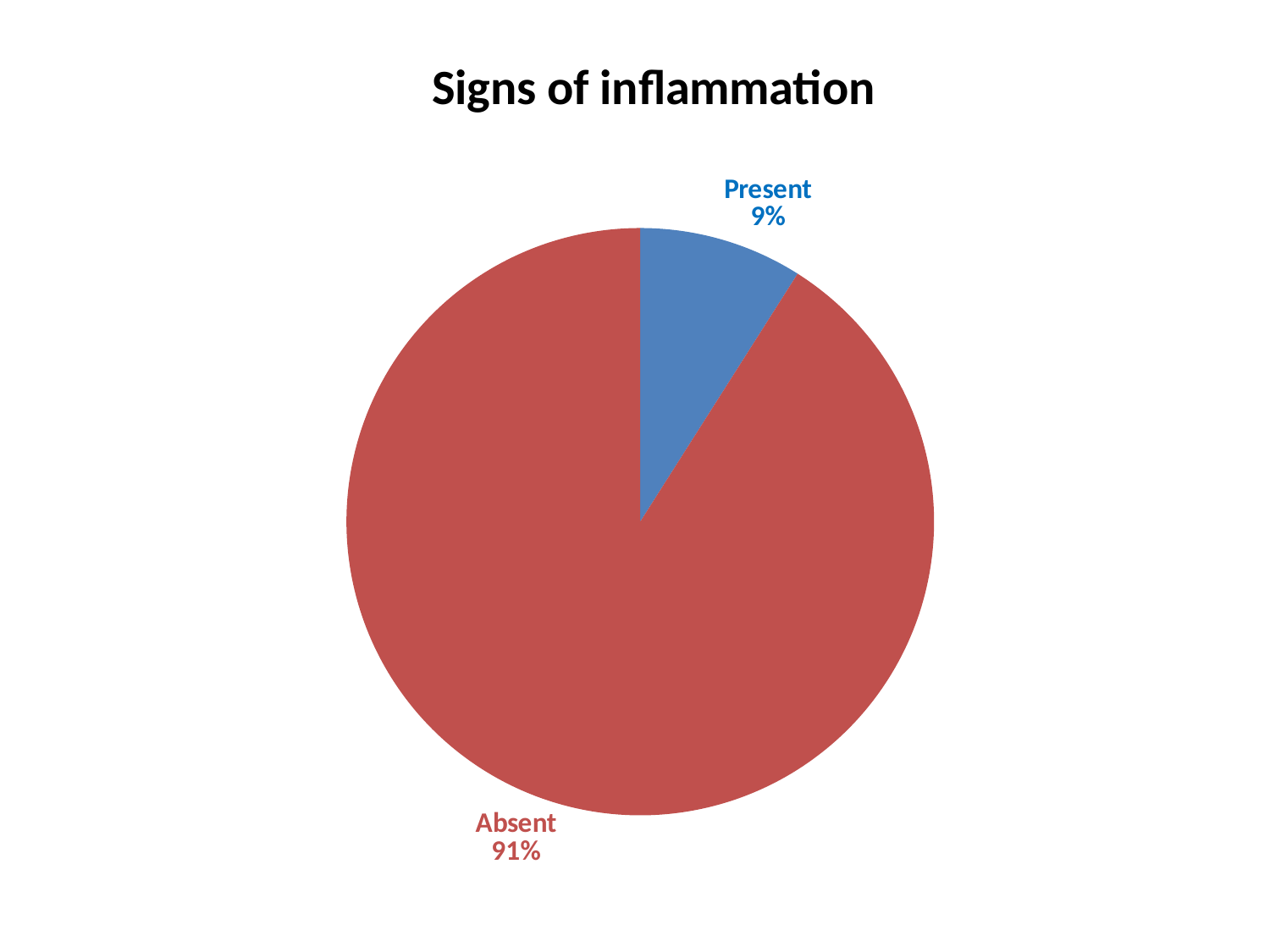
What share of the pie does the Present slice represent? 9% What percentage of the pie is labelled Present? 9% What is the difference in percentage points between the Absent and Present slices? 82 Which slice is the smallest? Present Which is larger, the Present slice or the Absent slice? Absent What kind of chart is shown on the slide? Pie chart How many slices does the pie chart have? 2 What percentage of the pie is labelled Absent? 91% Which slice is the largest? Absent What is the title of the chart? Signs of inflammation What colour is the Absent slice? Red